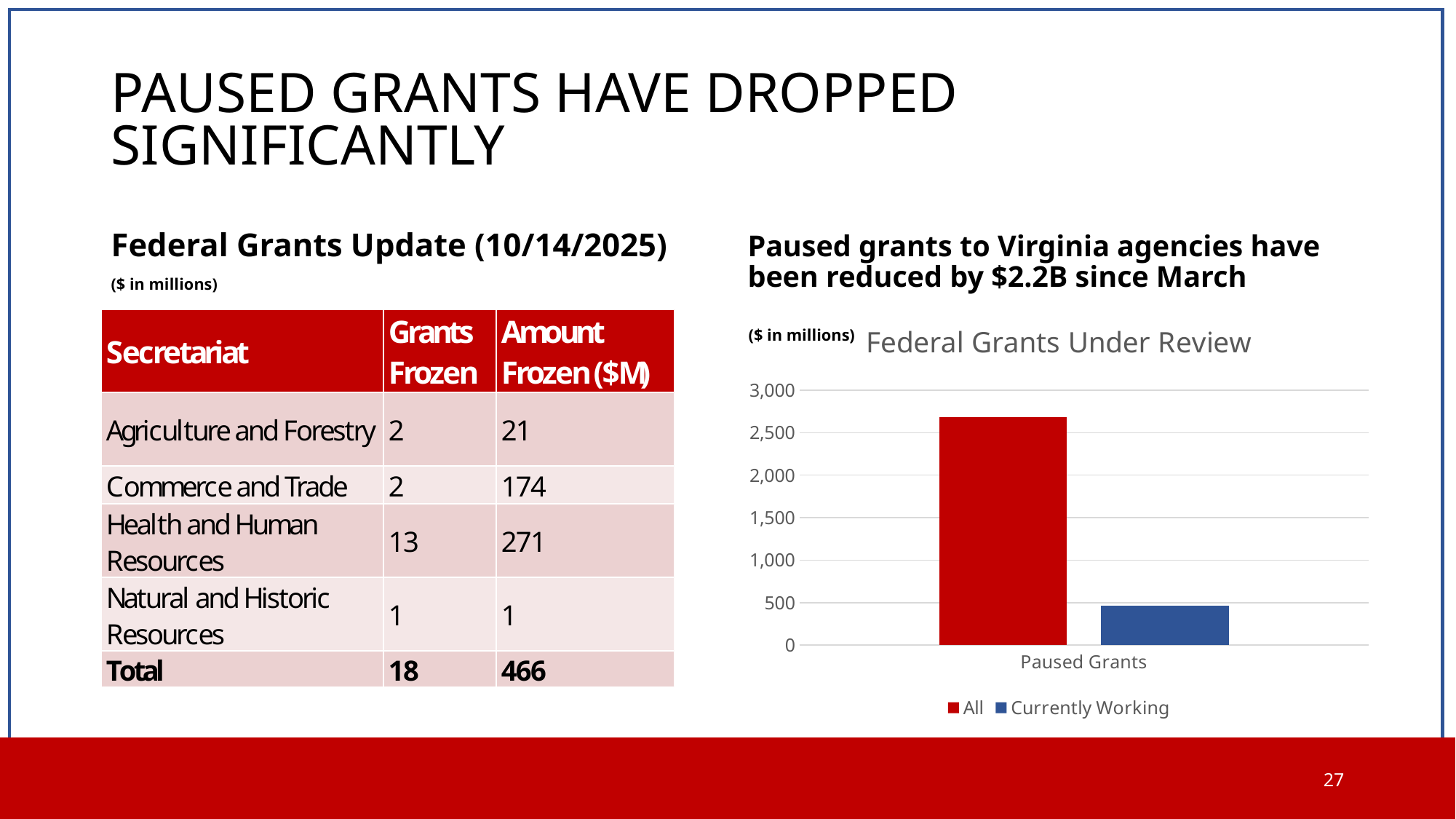
Is the value for the All series in the Federal Grants Under Review chart greater or less than 2,500? greater What is the highest tick value shown on the y axis of the Federal Grants Under Review chart? 3,000 How many categories are shown on the x axis of the Federal Grants Under Review chart? 1 How many series does the legend of the Federal Grants Under Review chart list? 2 In the Federal Grants Under Review chart, which series has the taller bar, All or Currently Working? All Is the value for the All series in the Federal Grants Under Review chart greater or less than 3,000? less What are the two series named in the legend of the Federal Grants Under Review chart? All and Currently Working In the Federal Grants Under Review chart, which series has the lowest value? Currently Working What is the category label on the x axis of the Federal Grants Under Review chart? Paused Grants In the Federal Grants Under Review chart, which series has the highest value? All Is the value for the Currently Working series in the Federal Grants Under Review chart greater or less than 1,000? less What kind of chart is shown on the slide? bar chart